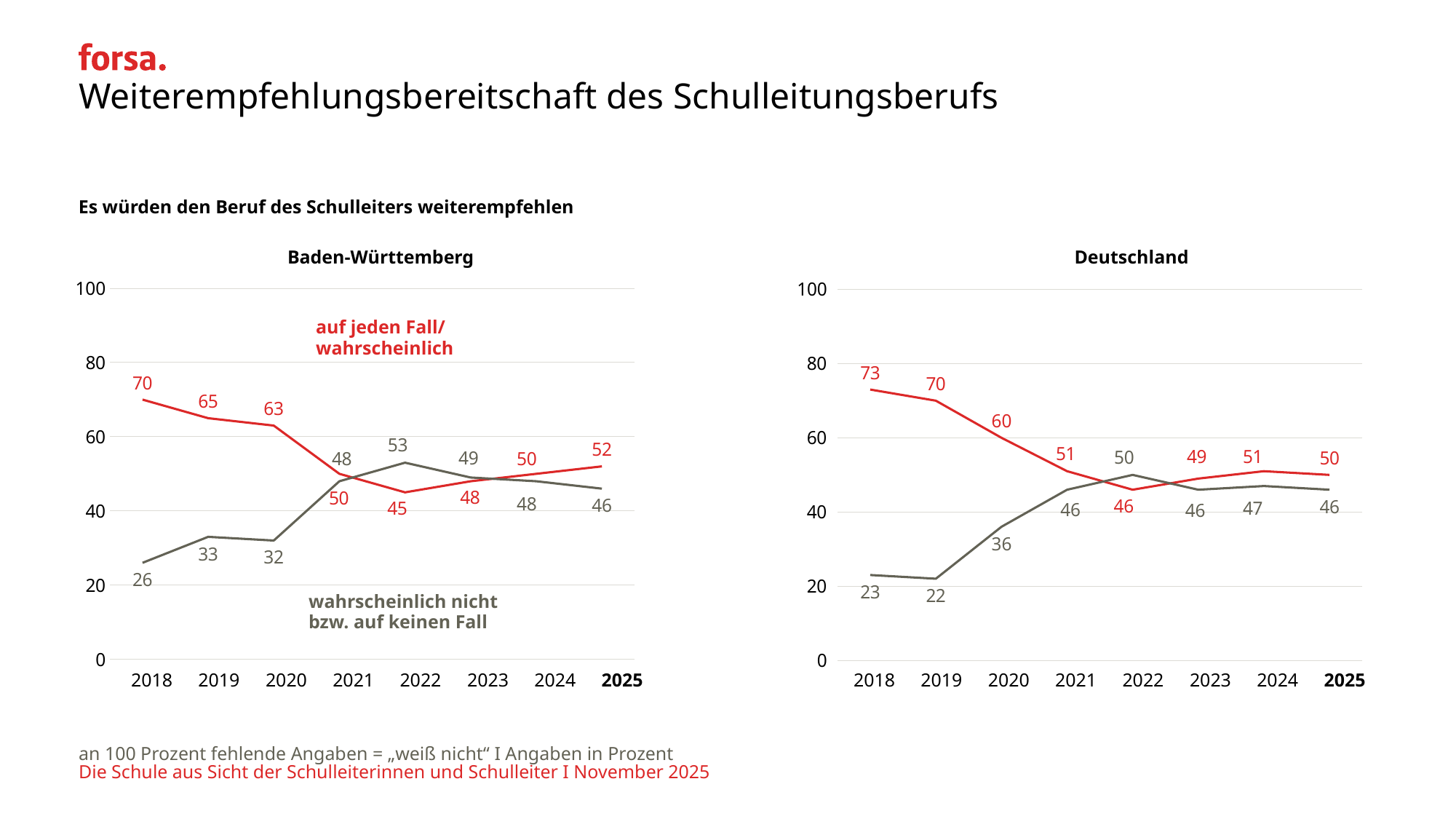
In the Deutschland chart, does the "wahrscheinlich nicht bzw. auf keinen Fall" line rise or fall from 2018 to 2022? rise In the Deutschland chart, which series has the higher value in 2020? auf jeden Fall/wahrscheinlich What kind of chart is the Baden-Württemberg chart? line chart How many years are shown on the x axis of the Baden-Württemberg chart? 8 In the Baden-Württemberg chart, what is the difference between the "auf jeden Fall/wahrscheinlich" value in 2018 and in 2025? 18 In the Baden-Württemberg chart, in which year is the "auf jeden Fall/wahrscheinlich" line at its lowest? 2022 In the Baden-Württemberg chart, which series has the higher value in 2022? wahrscheinlich nicht bzw. auf keinen Fall How many series are plotted in the Deutschland chart? 2 In the Deutschland chart, in which year is the "auf jeden Fall/wahrscheinlich" line at its highest? 2018 In the Deutschland chart, what is the value for "wahrscheinlich nicht bzw. auf keinen Fall" in 2019? 22 In the Baden-Württemberg chart, what is the value for "auf jeden Fall/wahrscheinlich" in 2018? 70 In the Deutschland chart, what is the difference between the two series in 2025? 4